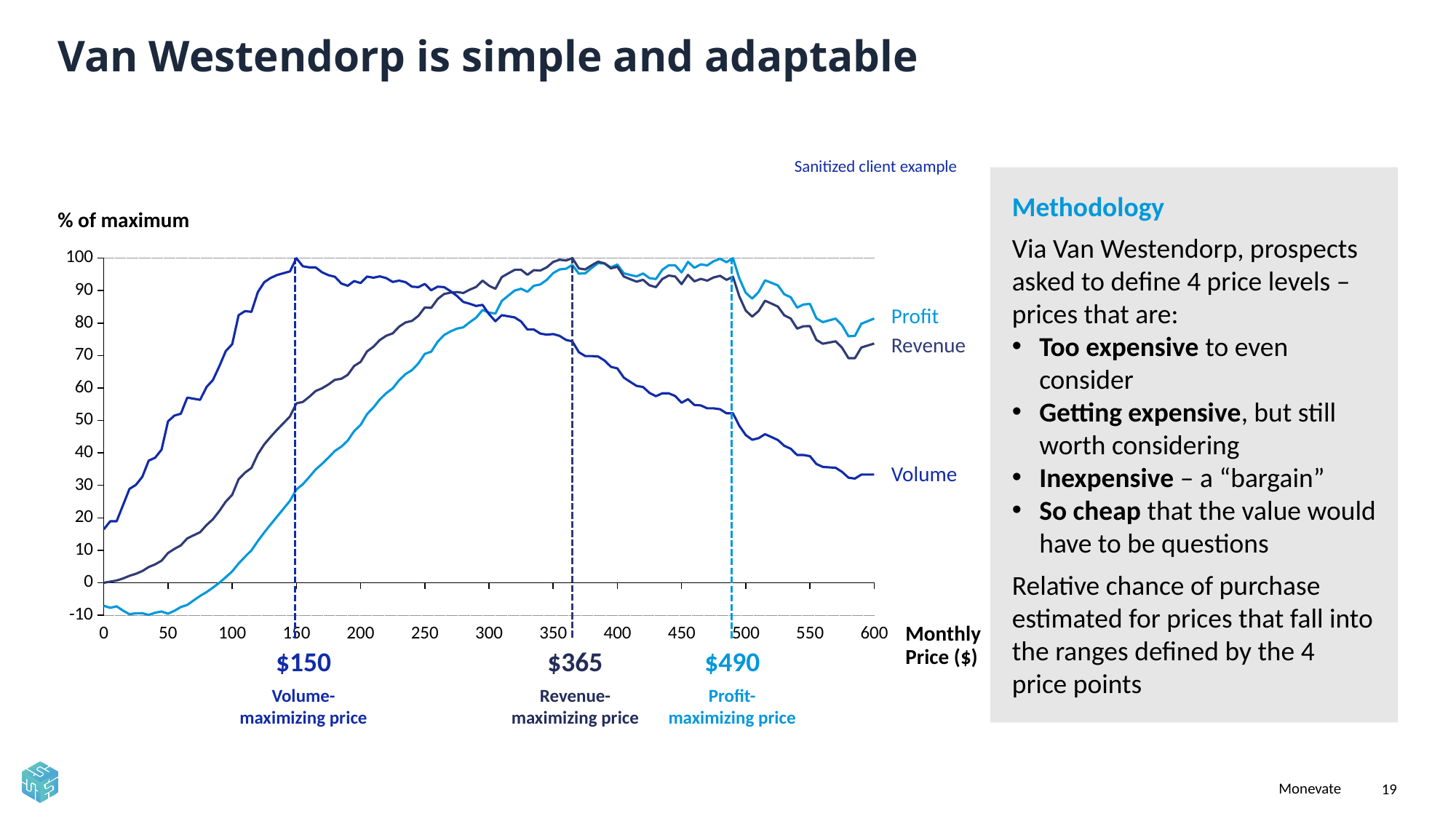
Is the Volume value at a monthly price of $600 greater or less than 40? less What is the label of the x axis? Monthly Price ($) What is the difference between the profit-maximizing price and the volume-maximizing price? $340 How many series are plotted on the chart? 3 What is the revenue-maximizing price shown on the chart? $365 Which series reaches its maximum at the lowest monthly price? Volume At a monthly price of $600, which is larger, Profit or Volume? Profit What is the volume-maximizing price shown on the chart? $150 What kind of chart is shown on the slide? Line chart Does the Volume series rise or fall as the monthly price increases from $150 to $600? Fall Is the Volume value at a monthly price of $100 greater or less than 70? greater What is the profit-maximizing price shown on the chart? $490